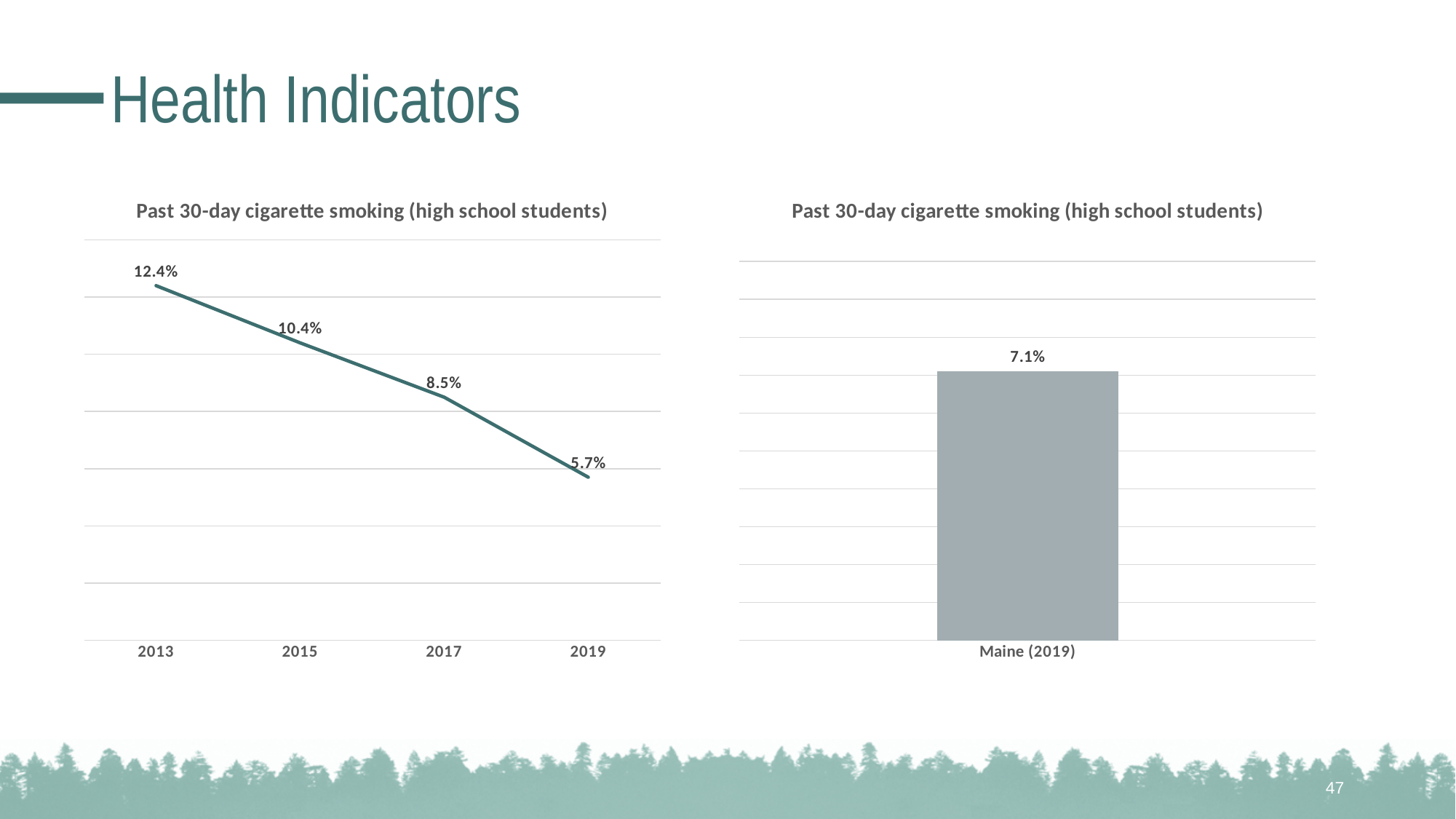
In the left-hand line chart, what is the difference between the 2015 and 2017 values? 1.9% In the left-hand line chart, what is the value for 2017? 8.5% In the left-hand line chart, what is the value for 2013? 12.4% In the left-hand line chart, what is the difference between the 2013 and 2019 values? 6.7% What kind of chart is the right-hand chart? bar chart In the right-hand bar chart, what is the value for Maine (2019)? 7.1% In the left-hand line chart, what is the value for 2019? 5.7% In the left-hand line chart, which year has the highest value? 2013 In the left-hand line chart, which year has the lowest value? 2019 How many years are plotted in the left-hand line chart? 4 In the left-hand line chart, do the values rise or fall from 2013 to 2019? fall Which is larger: the 2019 value in the left-hand line chart or the Maine (2019) value in the right-hand bar chart? Maine (2019)